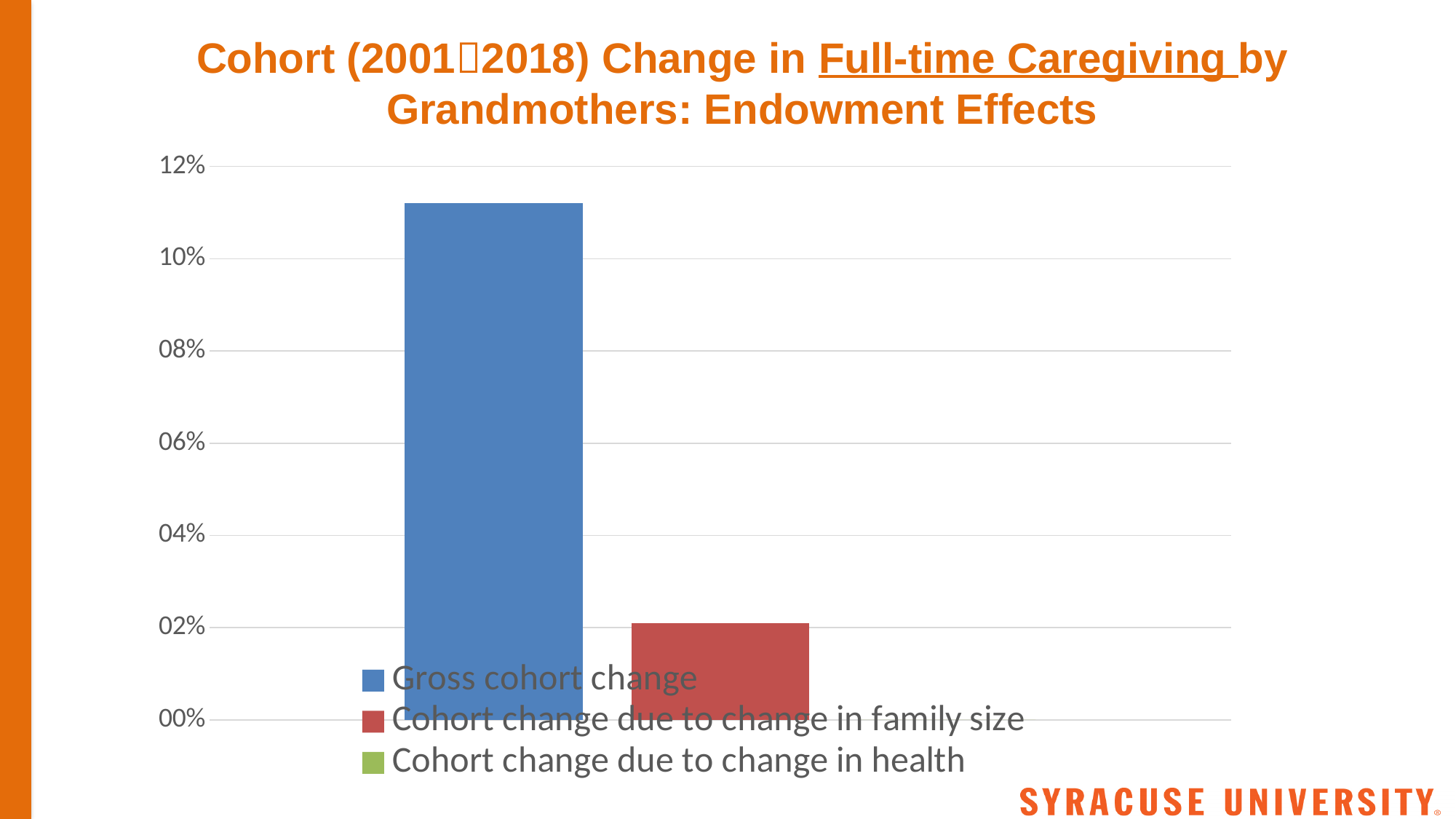
What is the highest value shown on the vertical axis? 12% Is the value for Cohort change due to change in family size greater or less than 6%? less How many series does the legend list? 3 Is the value for Gross cohort change greater or less than 12%? less How many bars are visibly plotted on the chart? 2 What colour is the bar for Gross cohort change? blue Which is larger, the bar for Gross cohort change or the bar for Cohort change due to change in family size? Gross cohort change Is the value for Cohort change due to change in family size greater or less than 4%? less Which series has the tallest bar? Gross cohort change What kind of chart is shown on the slide? bar chart